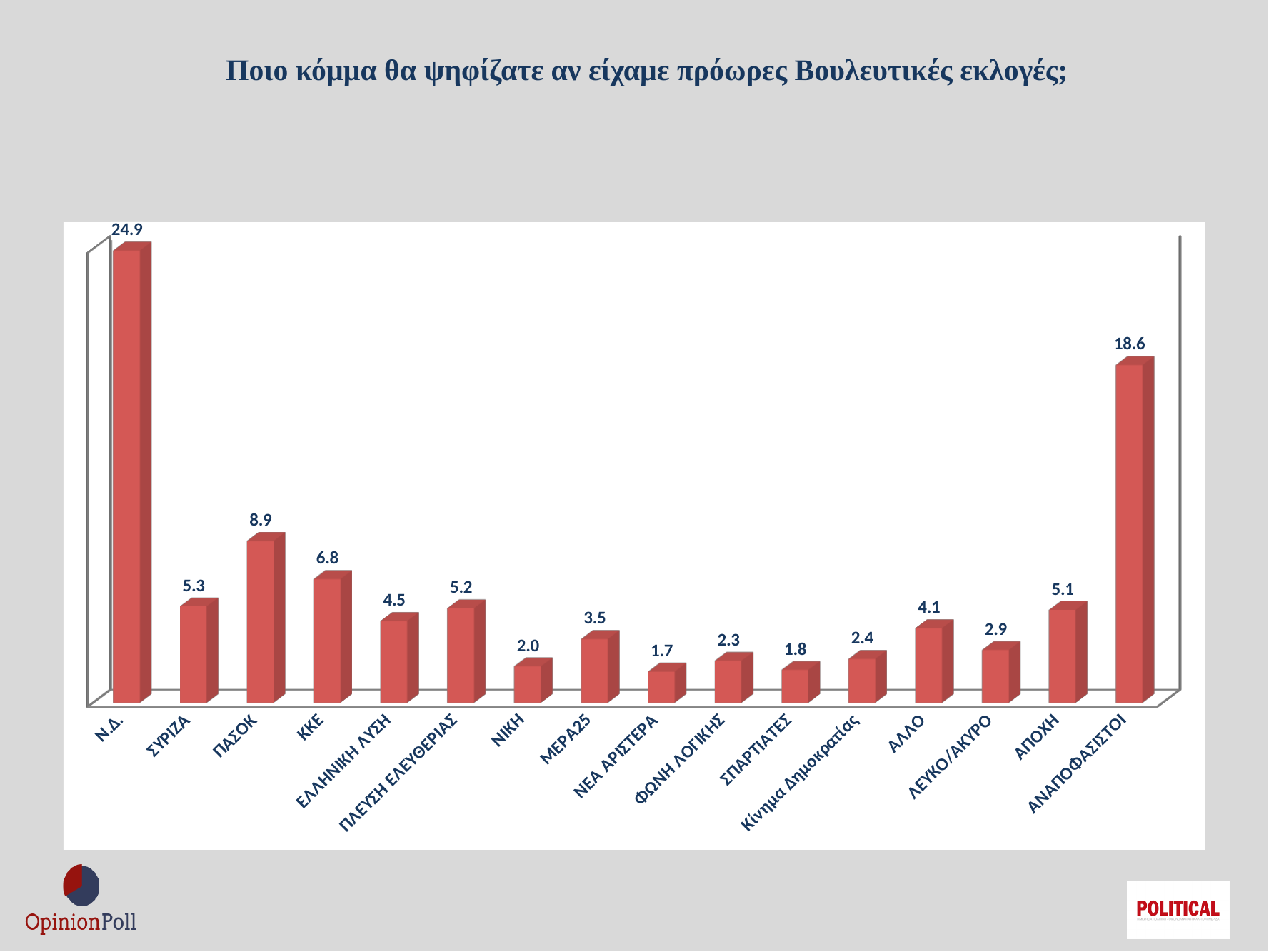
Which is larger, the value for ΣΥΡΙΖΑ or the value for ΚΚΕ? ΚΚΕ How many categories are shown on the x axis? 16 Which category has the highest value? Ν.Δ. What is the difference between the values for Ν.Δ. and ΑΝΑΠΟΦΑΣΙΣΤΟΙ? 6.3 What is the title of the chart? Ποιο κόμμα θα ψηφίζατε αν είχαμε πρόωρες Βουλευτικές εκλογές; What is the value for ΑΝΑΠΟΦΑΣΙΣΤΟΙ? 18.6 Which category has the lowest value? ΝΕΑ ΑΡΙΣΤΕΡΑ What is the difference between the values for ΠΑΣΟΚ and ΚΚΕ? 2.1 What is the value for Ν.Δ.? 24.9 What is the value for ΝΕΑ ΑΡΙΣΤΕΡΑ? 1.7 What kind of chart is shown on the slide? bar chart What is the value for ΠΑΣΟΚ? 8.9